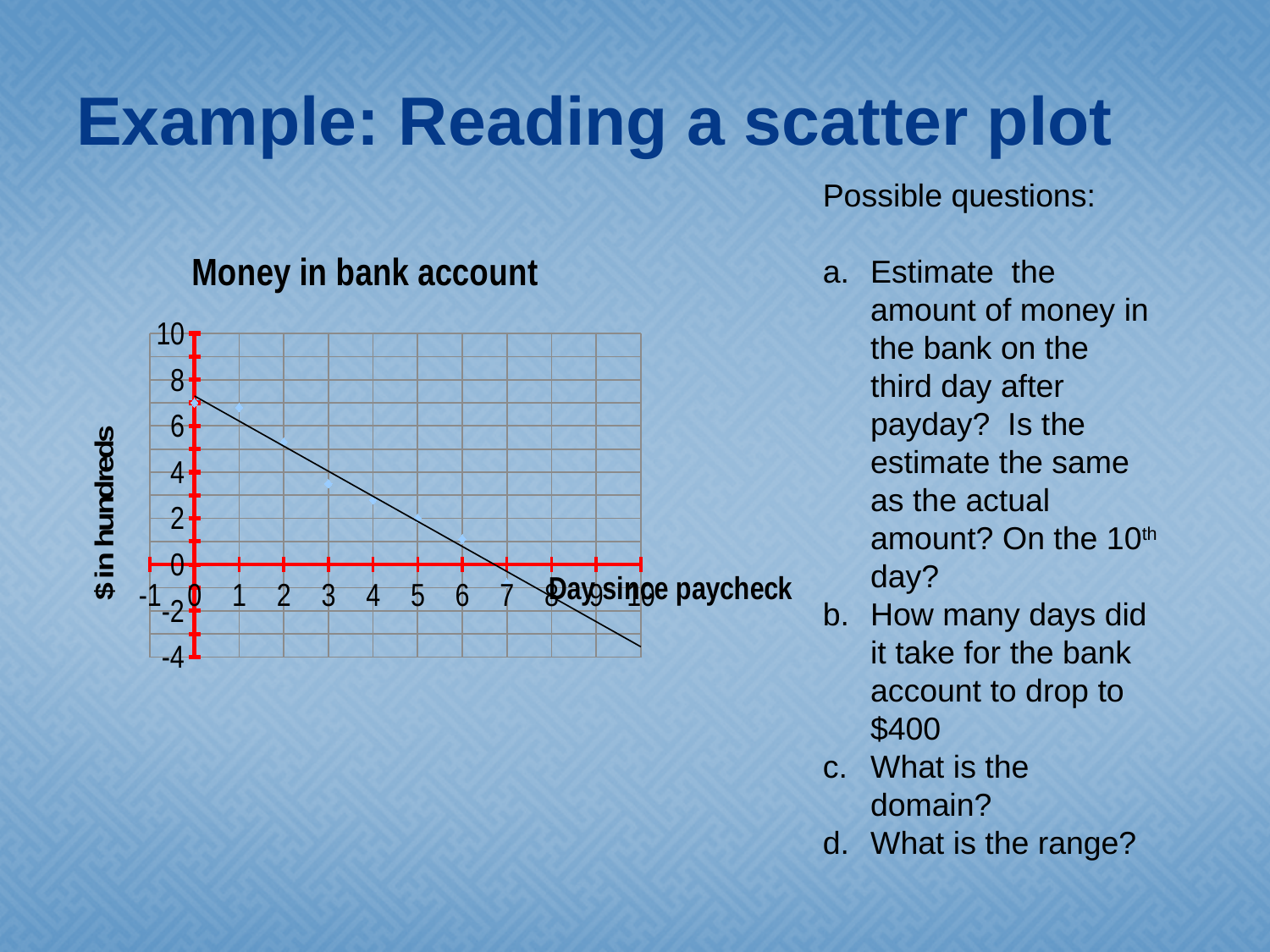
What is the label of the y axis of the chart? $ in hundreds Is the value for day 0 greater or less than 6? greater What kind of chart is shown on the slide? scatter plot What is the title of the chart? Money in bank account Is the value for day 5 greater or less than 4? less Is the value for day 1 greater or less than 4? greater At which day is the plotted value highest? day 0 Do the plotted values rise or fall as the days since paycheck increase? fall Which has the larger value, day 0 or day 6? day 0